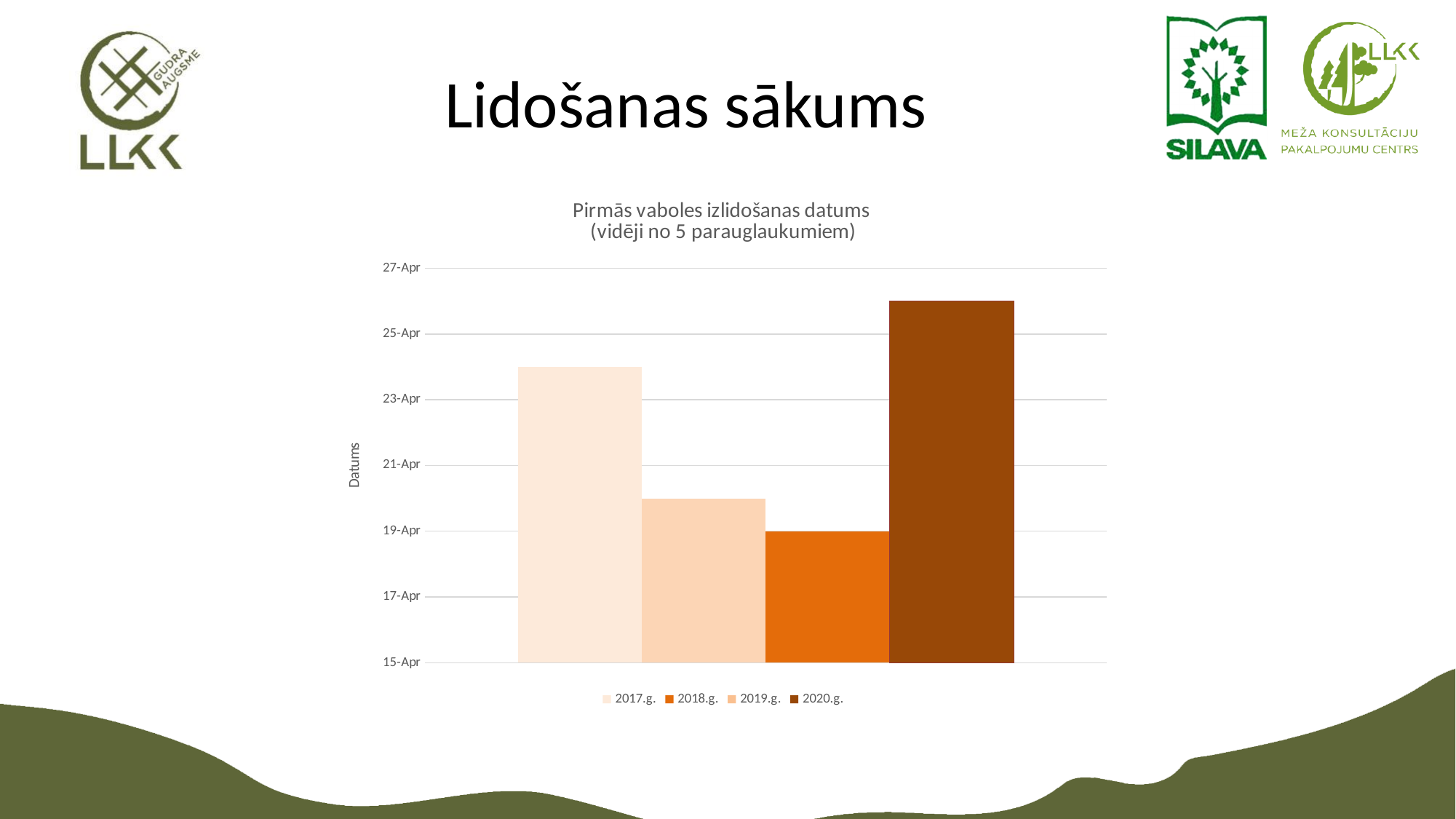
How many bars are plotted in the chart? 4 What is the first-flight date for 2018.g.? 20-Apr Which year has the latest (highest) first-flight date? 2020.g. What kind of chart is shown on the slide? bar chart Is the value for 2020.g. later or earlier than 25-Apr? later What is the label on the vertical axis? Datums Is the value for 2017.g. later or earlier than 23-Apr? later Is the value for 2019.g. later or earlier than 21-Apr? earlier How many series does the legend list? 4 What is the title of the chart? Pirmās vaboles izlidošanas datums (vidēji no 5 parauglaukumiem) Which year has the earliest (lowest) first-flight date? 2019.g. Which is later, the date for 2017.g. or the date for 2019.g.? 2017.g.